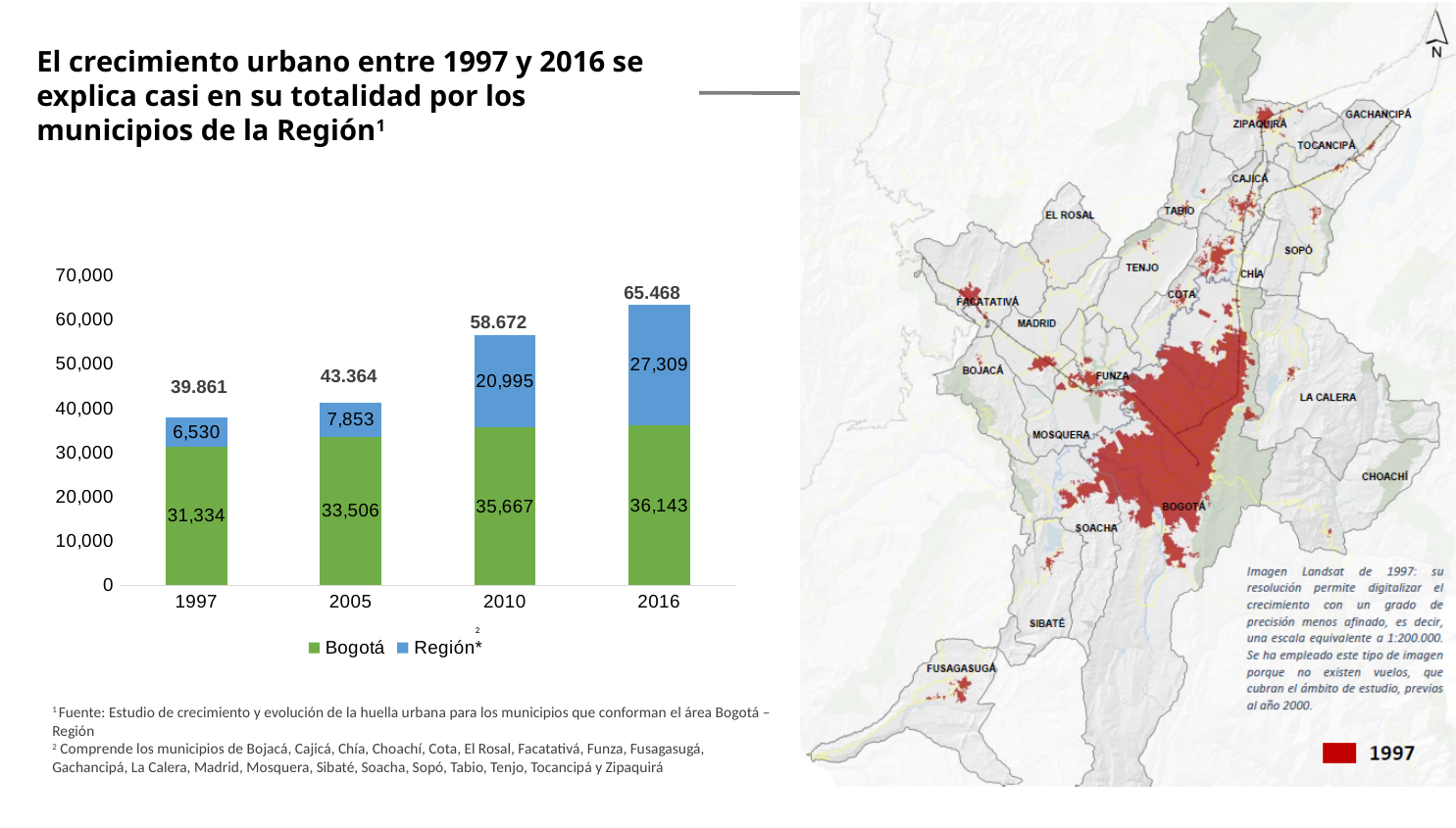
Which is larger, the Bogotá value in 2005 or the Región value in 2005? Bogotá What is the value for Bogotá in 1997? 31,334 Which year has the lowest value for Bogotá? 1997 What is the value for Bogotá in 2016? 36,143 What is the total shown above the stacked bar for 2005? 43.364 How many years are shown on the x axis of the chart? 4 What kind of chart is shown on the slide? Stacked bar chart Which year has the highest value for Región? 2016 What is the total shown above the stacked bar for 2016? 65.468 What is the value for Región in 2010? 20,995 How many series does the chart legend list? 2 What is the difference between the Región values for 2016 and 2010? 6,314